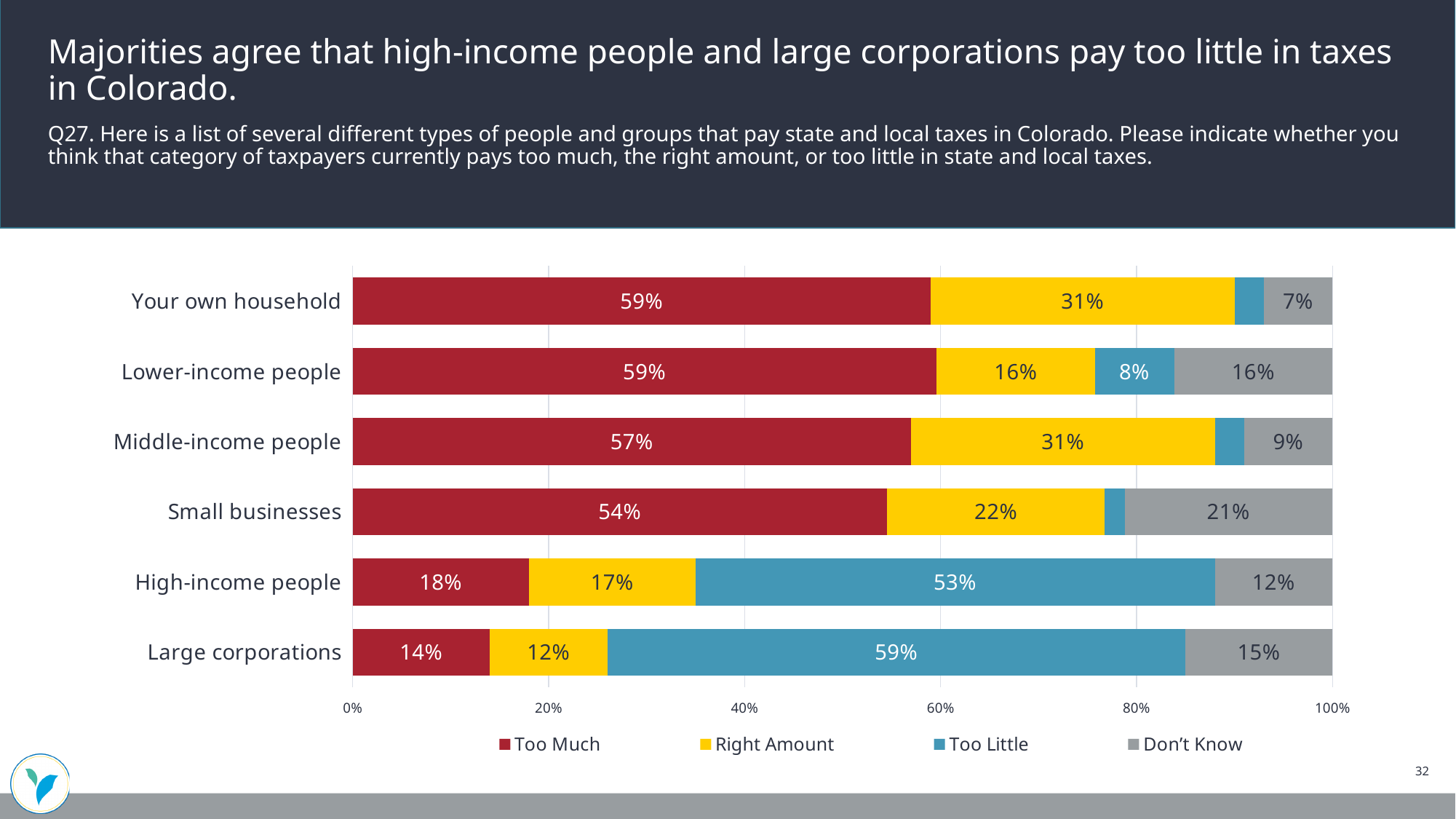
What is the difference between the 'Too Little' values for Large corporations and High-income people? 6% What is the 'Don't Know' value for Lower-income people? 16% What is the 'Too Much' value for Small businesses? 54% What kind of chart is shown on the slide? Stacked bar chart How many series does the legend list? 4 What percentage of respondents say large corporations pay too little in taxes? 59% Which is larger: the 'Don't Know' value for Small businesses or for Middle-income people? Small businesses Which category has the lowest 'Too Much' value? Large corporations What is the 'Right Amount' value for High-income people? 17% Which category has the highest 'Too Little' value? Large corporations Is the 'Too Much' value for Your own household greater or less than 40%? greater How many taxpayer categories are shown in the chart? 6